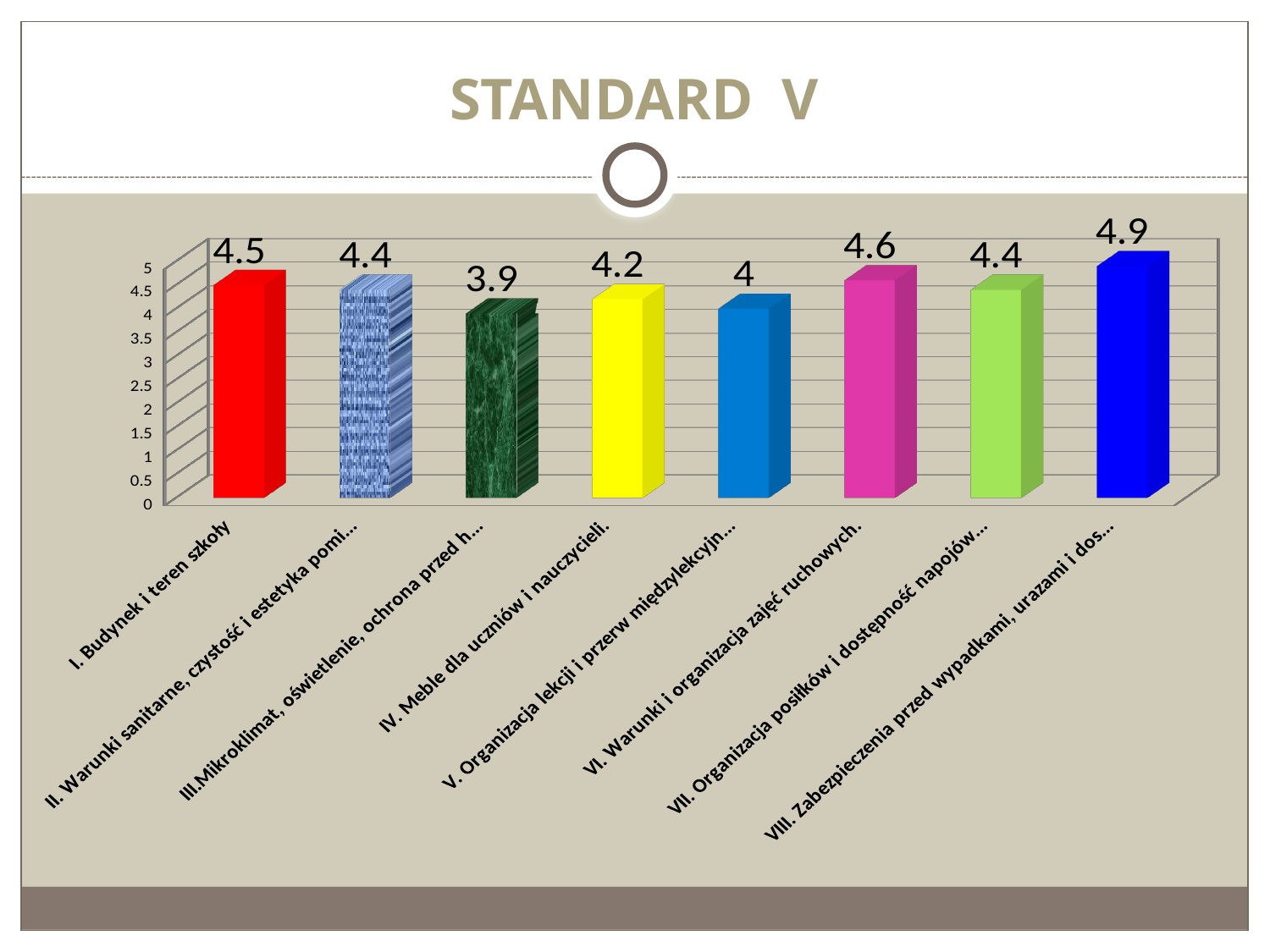
What is the value for category V (Organizacja lekcji i przerw międzylekcyjn...)? 4 Which is larger, the value for "I. Budynek i teren szkoły" or the value for "IV. Meble dla uczniów i nauczycieli."? I. Budynek i teren szkoły What is the difference between the values for category VIII and category III? 1 Which category has the highest value? VIII. Zabezpieczenia przed wypadkami, urazami i dos... What is the value for category III (Mikroklimat, oświetlenie...)? 3.9 What is the title of the slide? STANDARD V What is the value for "VI. Warunki i organizacja zajęć ruchowych."? 4.6 How many categories are shown in the chart? 8 What kind of chart is shown on the slide? Bar chart What is the value for "I. Budynek i teren szkoły"? 4.5 Which category has the lowest value? III.Mikroklimat, oświetlenie, ochrona przed h... What is the value for "IV. Meble dla uczniów i nauczycieli."? 4.2